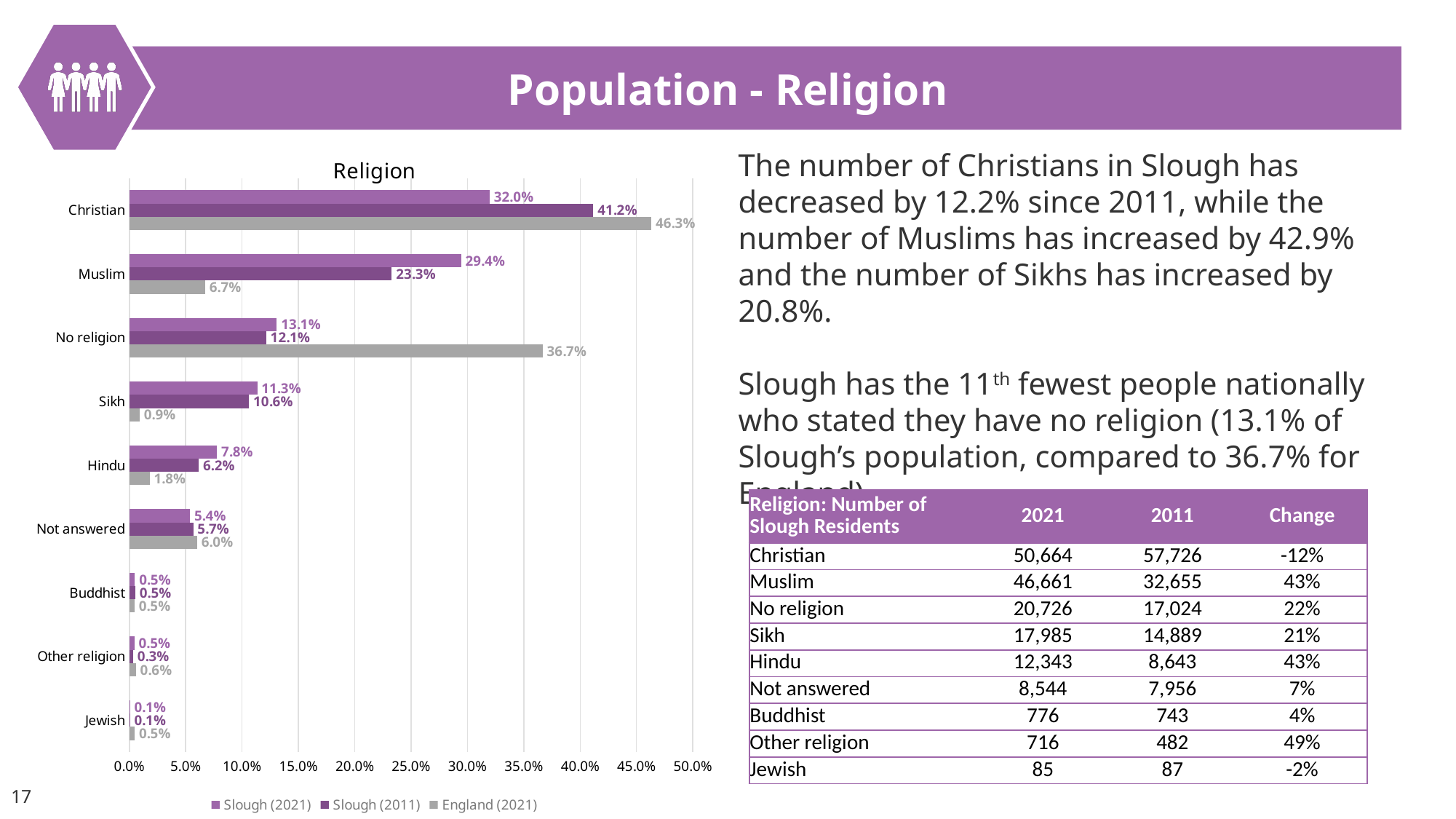
Which religion category has the lowest Slough (2021) value in the Religion chart? Jewish What is the England (2021) value for No religion in the Religion chart? 36.7% Which religion category has the highest England (2021) value in the Religion chart? Christian What is the difference between the Slough (2011) and Slough (2021) values for Christian in the Religion chart? 9.2% What are the three series listed in the legend of the Religion chart? Slough (2021), Slough (2011), England (2021) What is the Slough (2021) value for Christian in the Religion chart? 32.0% How many religion categories are shown in the Religion chart? 9 What kind of chart is the Religion chart? Bar chart How many series does the legend of the Religion chart list? 3 In the Religion chart, is the Slough (2021) value for Sikh larger than the England (2021) value for Sikh? Yes In the Religion chart, is the England (2021) value for Christian greater or less than 45.0%? greater What is the Slough (2011) value for Muslim in the Religion chart? 23.3%